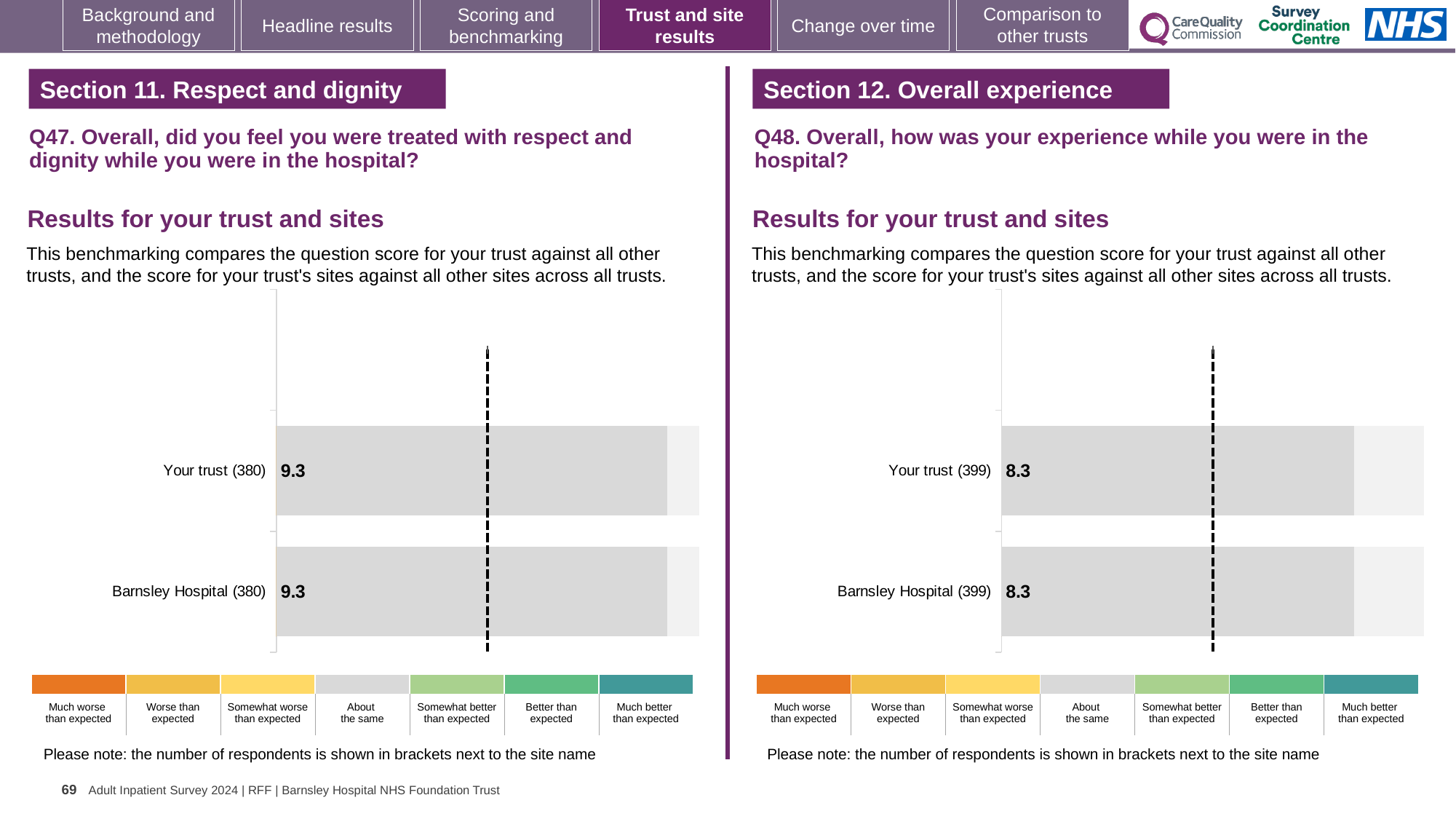
On the right chart (Q48), what is the difference between the score for Your trust and the score for Barnsley Hospital? 0 What kind of chart is used on the left (Q47) to show the results for your trust and sites? Bar chart On the left chart (Q47), what is the difference between the score for Your trust and the score for Barnsley Hospital? 0 On the left chart (Q47, respect and dignity), what is the score for Barnsley Hospital? 9.3 On the left chart (Q47), how many respondents are shown in brackets next to Your trust? 380 How many bars are plotted on the left chart (Q47)? 2 On the right chart (Q48, overall experience), what is the score for Your trust? 8.3 How many bars are plotted on the right chart (Q48)? 2 On the left chart (Q47, respect and dignity), what is the score for Your trust? 9.3 On the right chart (Q48), how many respondents are shown in brackets next to Barnsley Hospital? 399 On the right chart (Q48, overall experience), what is the score for Barnsley Hospital? 8.3 Is the score for Your trust on the left chart (Q47) larger or smaller than the score for Your trust on the right chart (Q48)? Larger